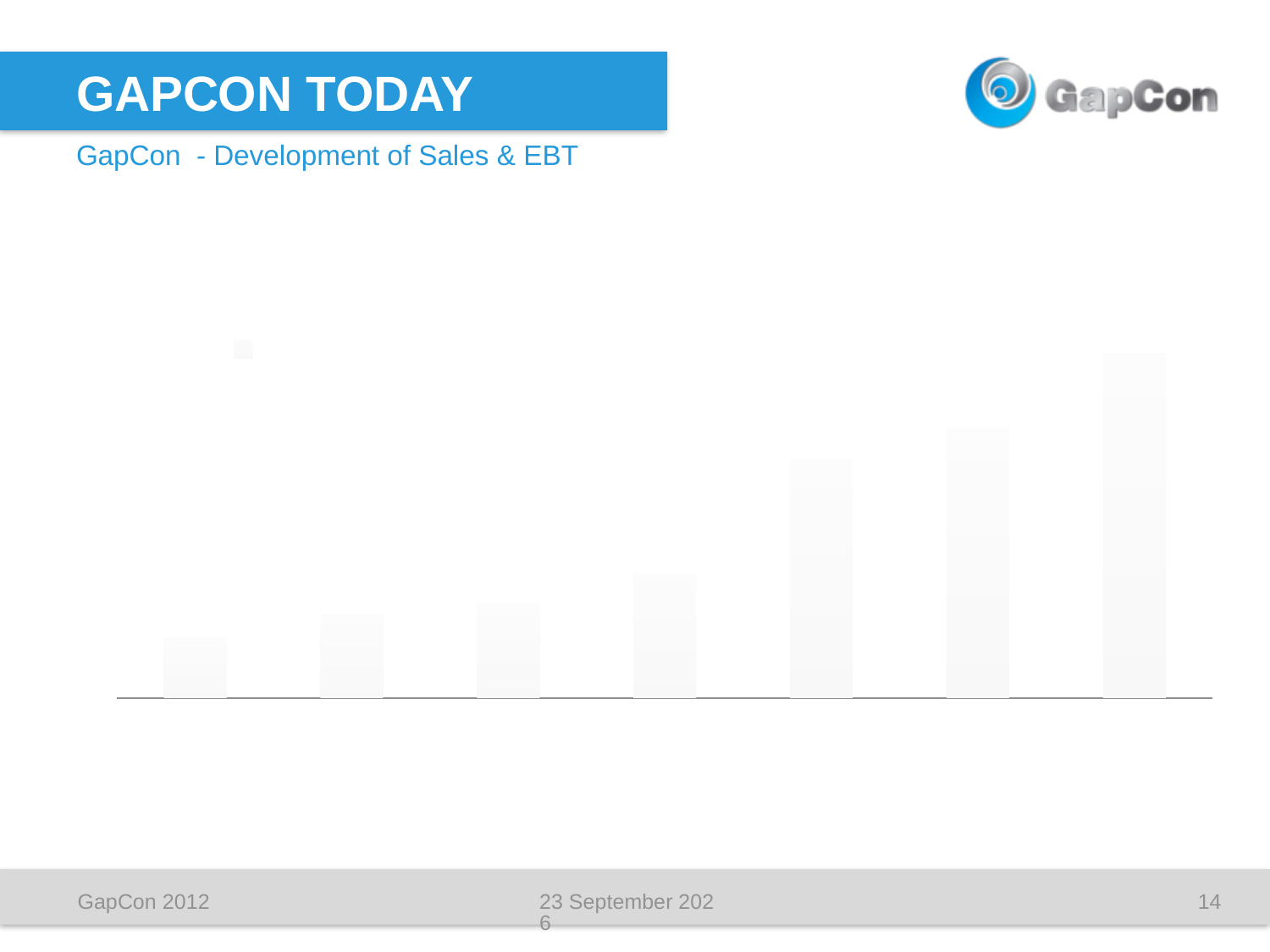
Which bar is the shortest: the leftmost or the rightmost? the leftmost How many bars are plotted in the chart? 7 Are the bars in the chart vertical or horizontal? vertical What kind of chart is shown on the slide? bar chart Which bar is the tallest: the leftmost or the rightmost? the rightmost What subtitle describes the chart on the slide? GapCon - Development of Sales & EBT Do the bar heights rise or fall from left to right across the chart? rise Is the leftmost bar taller or shorter than the rightmost bar? shorter